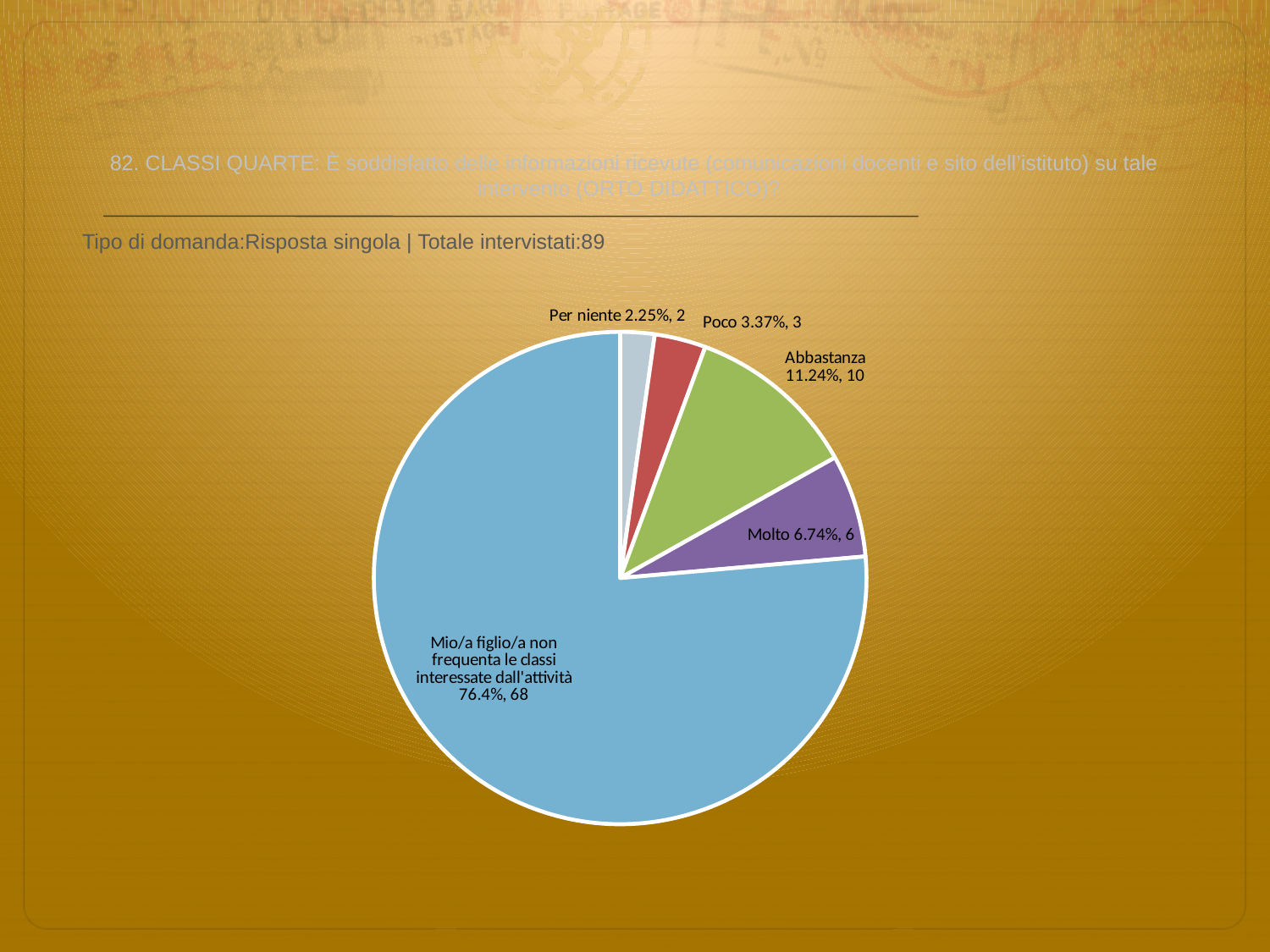
What percentage is shown for the 'Abbastanza' slice? 11.24% What is the total number of respondents stated on the slide? 89 What percentage is shown for 'Per niente'? 2.25% Which slice is the largest in the pie chart? Mio/a figlio/a non frequenta le classi interessate dall'attività What count is shown for the 'Poco' slice? 3 Which has a larger count, 'Poco' or 'Molto'? Molto How many slices does the pie chart have? 5 What share of the pie does the 'Mio/a figlio/a non frequenta le classi interessate dall'attività' slice represent? 76.4% How many respondents answered 'Molto'? 6 What is the difference in count between 'Abbastanza' and 'Molto'? 4 What kind of chart is shown on the slide? pie chart Which slice is the smallest in the pie chart? Per niente